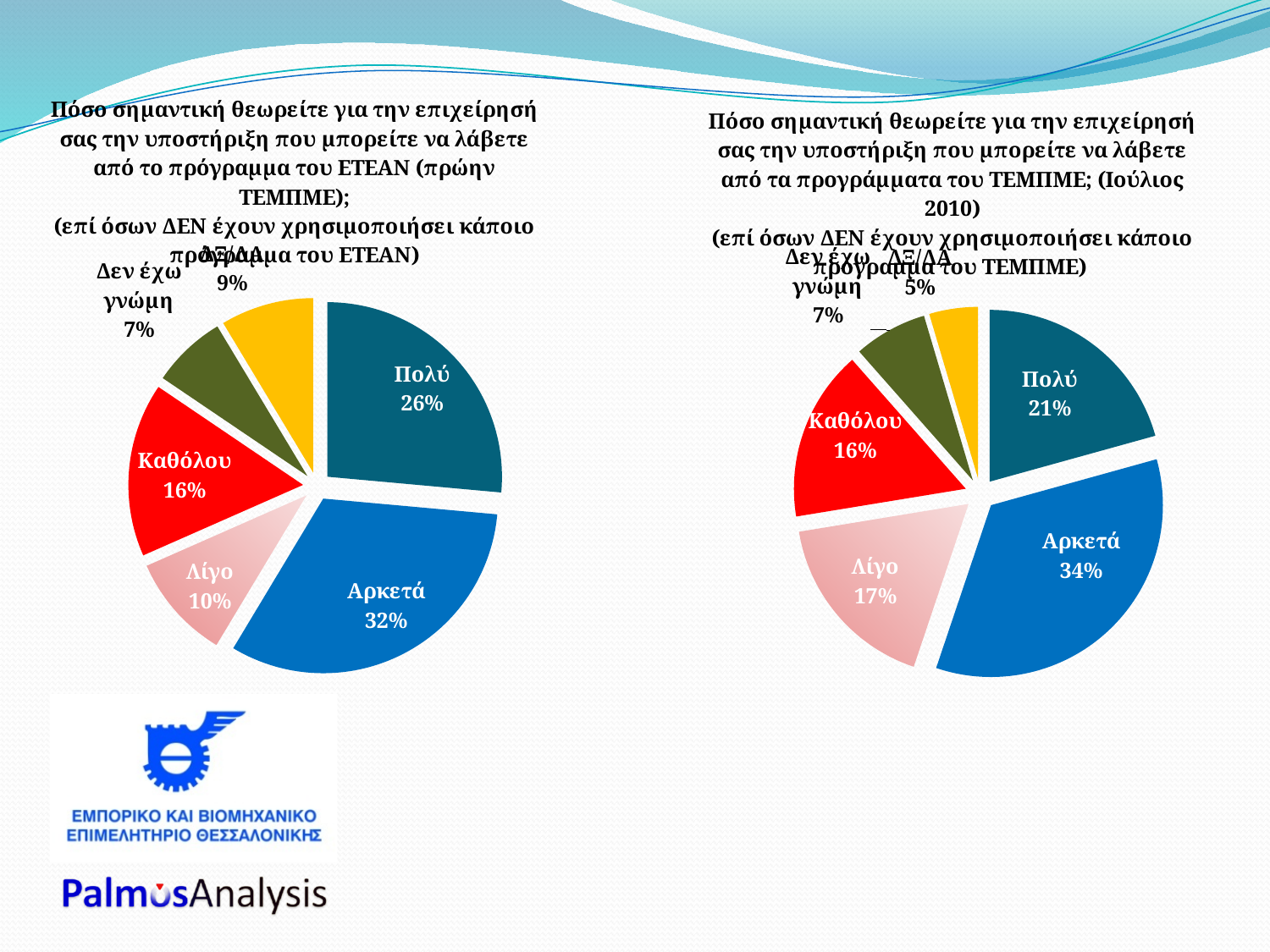
In the right pie chart (ΤΕΜΠΜΕ, Ιούλιος 2010), what share is labelled "ΔΞ/ΔΑ"? 5% How many slices does the left pie chart (ETEAN) have? 6 In the right pie chart (ΤΕΜΠΜΕ, Ιούλιος 2010), which category has the smallest share? ΔΞ/ΔΑ In the right pie chart (ΤΕΜΠΜΕ, Ιούλιος 2010), what is the combined share of "Πολύ" and "Αρκετά"? 55% In the right pie chart (ΤΕΜΠΜΕ, Ιούλιος 2010), what share is labelled "Πολύ"? 21% In the left pie chart (ETEAN), what share is labelled "Δεν έχω γνώμη"? 7% In the left pie chart (ETEAN), which category has the largest share? Αρκετά In the left pie chart (ETEAN), what colour is the "Καθόλου" slice? Red In the left pie chart (ETEAN), what is the difference between the "Πολύ" and "Λίγο" shares? 16% In the right pie chart (ΤΕΜΠΜΕ, Ιούλιος 2010), which is larger: "Λίγο" or "Καθόλου"? Λίγο What type of chart is used on the right side of the slide (ΤΕΜΠΜΕ, Ιούλιος 2010)? Pie chart In the left pie chart (ETEAN), what share is labelled "Αρκετά"? 32%